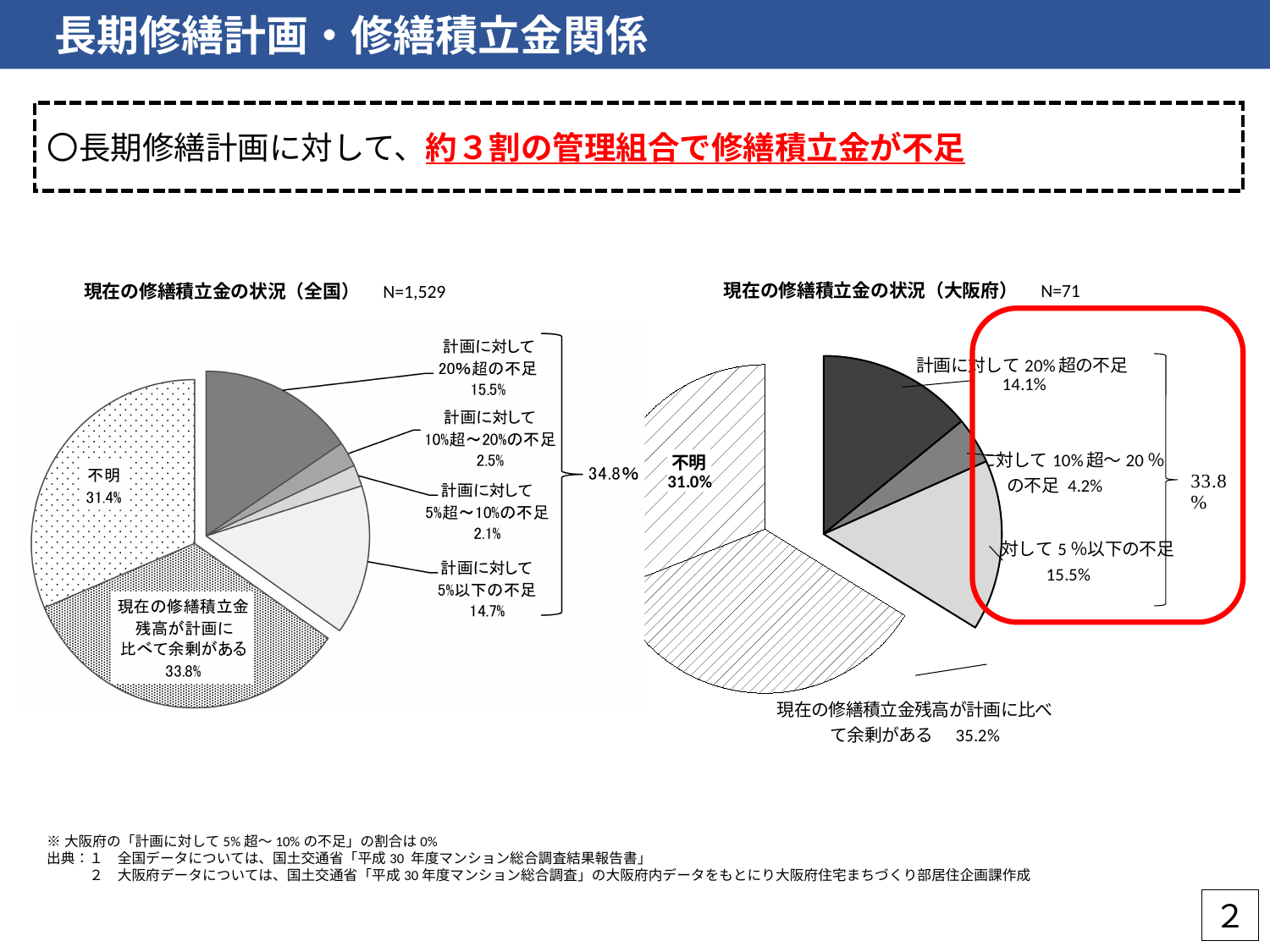
「現在の修繕積立金の状況（大阪府）」のグラフのサンプル数（N）はいくつですか？ N=71 「現在の修繕積立金の状況（全国）」のグラフで、最も割合が小さい区分はどれですか？ 計画に対して5%超～10%の不足 「現在の修繕積立金の状況（全国）」のグラフで、「計画に対して20%超の不足」の割合はいくらですか？ 15.5% 「現在の修繕積立金の状況（大阪府）」のグラフで、「不明」と「計画に対して20%超の不足」の割合の差はいくらですか？ 16.9% 「現在の修繕積立金の状況（大阪府）」のグラフで、不足に該当する区分の合計割合はいくらですか？ 33.8% このスライドのグラフはどの種類のグラフですか？ 円グラフ 「現在の修繕積立金の状況（全国）」のグラフで、最も割合が大きい区分はどれですか？ 現在の修繕積立金残高が計画に比べて余剰がある 「現在の修繕積立金の状況（全国）」のグラフで、「不明」と「計画に対して5%以下の不足」ではどちらの割合が大きいですか？ 不明 「現在の修繕積立金の状況（大阪府）」のグラフで、「計画に対して10%超～20%の不足」と「計画に対して5%以下の不足」ではどちらの割合が大きいですか？ 計画に対して5%以下の不足 「現在の修繕積立金の状況（全国）」のグラフで、不足に該当する区分の合計割合はいくらですか？ 34.8% 「現在の修繕積立金の状況（大阪府）」のグラフで、「現在の修繕積立金残高が計画に比べて余剰がある」の割合はいくらですか？ 35.2% 「現在の修繕積立金の状況（全国）」のグラフには、いくつの区分がありますか？ 6